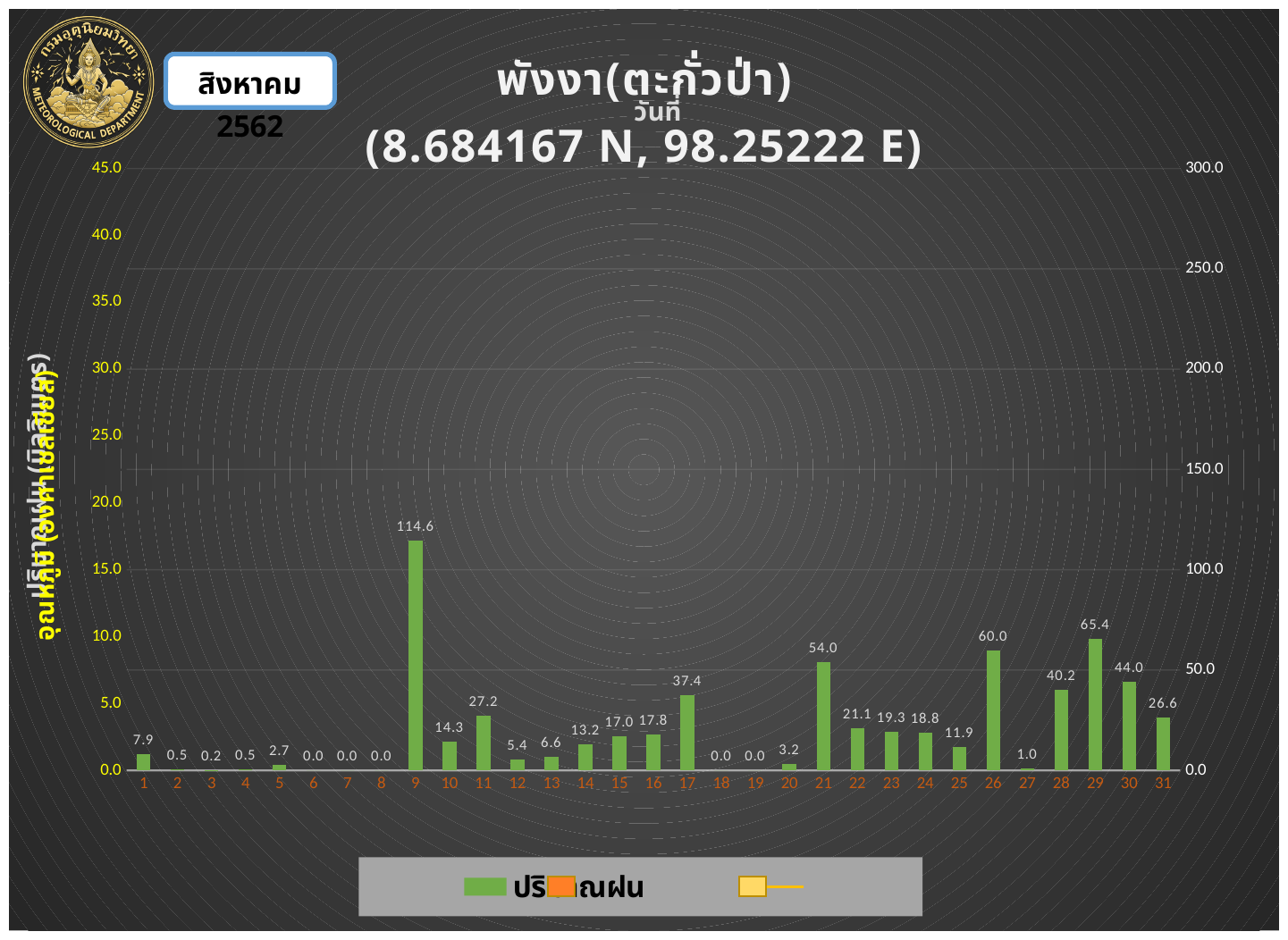
What is the value for day 9? 114.6 What is the value for day 29? 65.4 What is the value for day 21? 54.0 How many days are shown on the x axis? 31 What coordinates are shown in the chart title? 8.684167 N, 98.25222 E Which is larger, the value for day 26 or the value for day 21? day 26 What is the difference between the values for day 29 and day 26? 5.4 Which day has the highest value? 9 What kind of chart is shown? bar chart What is the difference between the values for day 30 and day 28? 3.8 What is the value for day 17? 37.4 Is the value for day 17 greater or less than 50.0 on the right axis? less